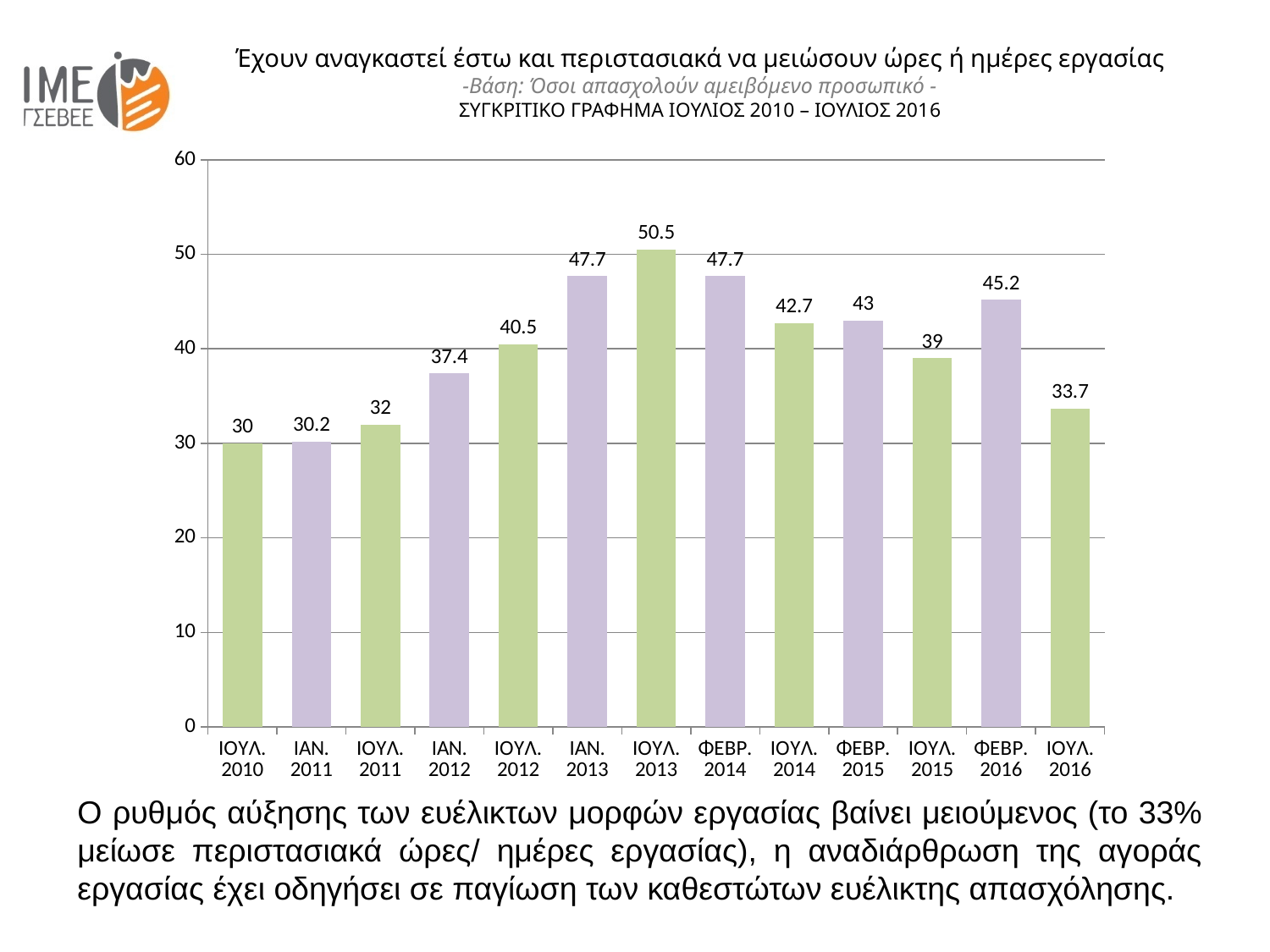
What kind of chart is shown on the slide? bar chart What is the value for ΙΑΝ. 2012? 37.4 What is the difference between the values for ΦΕΒΡ. 2016 and ΙΟΥΛ. 2015? 6.2 What is the value for ΙΟΥΛ. 2013? 50.5 Which category has the lowest value? ΙΟΥΛ. 2010 What is the value for ΙΟΥΛ. 2016? 33.7 Is the value for ΙΟΥΛ. 2012 greater or less than 40? greater Do the values rise or fall from ΙΟΥΛ. 2010 to ΙΟΥΛ. 2013? rise What is the difference between the values for ΙΟΥΛ. 2013 and ΙΟΥΛ. 2016? 16.8 Which is larger, the value for ΙΟΥΛ. 2014 or the value for ΦΕΒΡ. 2015? ΦΕΒΡ. 2015 How many categories are shown on the x axis? 13 Which category has the highest value? ΙΟΥΛ. 2013